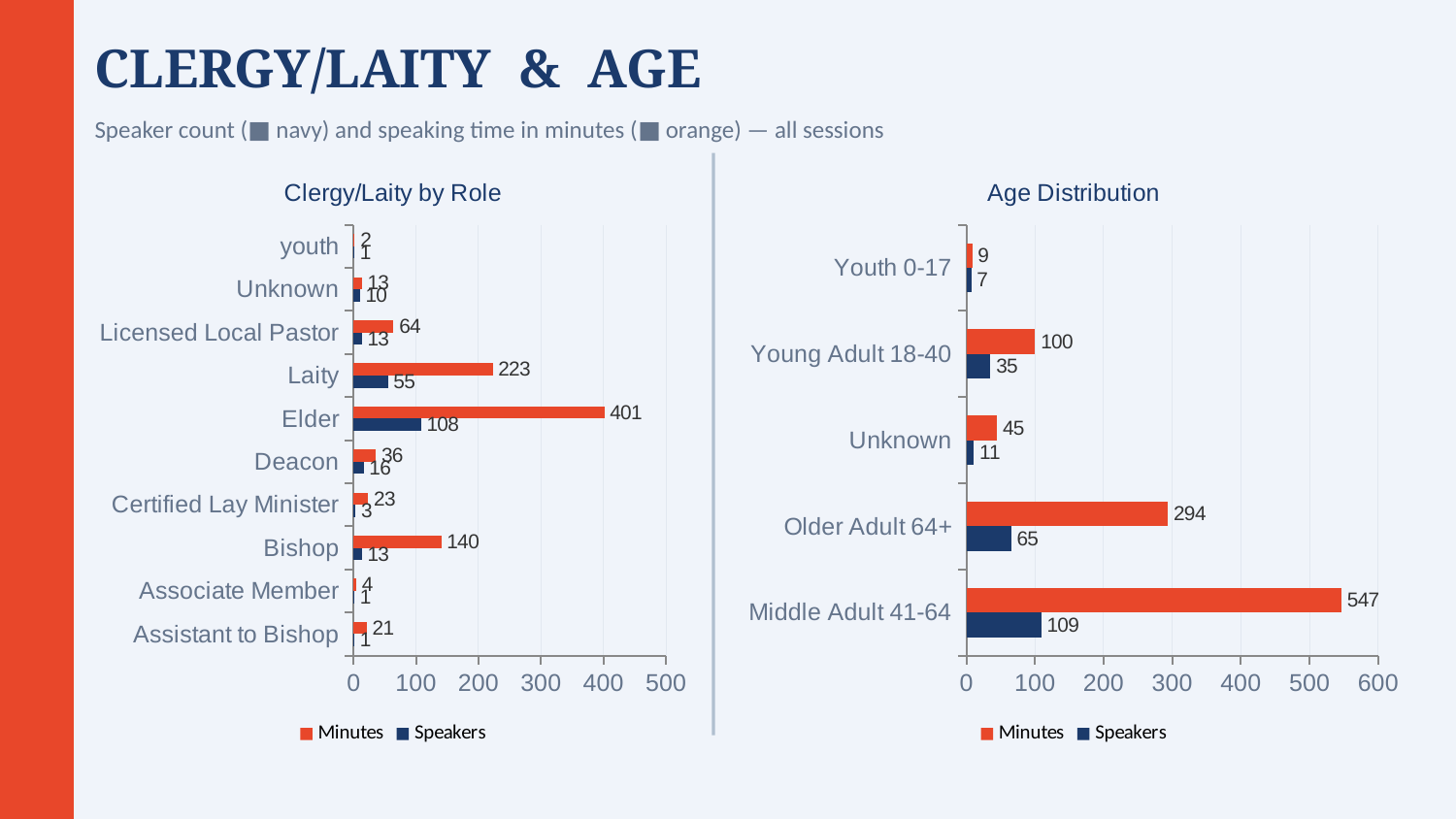
In the Age Distribution chart, which age group has the lowest number of speakers? Youth 0-17 In the Clergy/Laity by Role chart, which role has the highest number of minutes? Elder In the Age Distribution chart, how many minutes are shown for Older Adult 64+? 294 In the Clergy/Laity by Role chart, how many role categories are listed? 10 In the Clergy/Laity by Role chart, how many minutes are shown for Elder? 401 In the Clergy/Laity by Role chart, what is the difference in minutes between Laity and Bishop? 83 How many series does the legend of the Age Distribution chart list? 2 In the Clergy/Laity by Role chart, how many speakers are shown for Laity? 55 In the Age Distribution chart, what is the difference in speakers between Middle Adult 41-64 and Older Adult 64+? 44 In the Age Distribution chart, how many speakers are shown for Young Adult 18-40? 35 What type of chart is the Clergy/Laity by Role chart? Bar chart In the Age Distribution chart, which is larger: the minutes for Unknown or the minutes for Young Adult 18-40? Young Adult 18-40